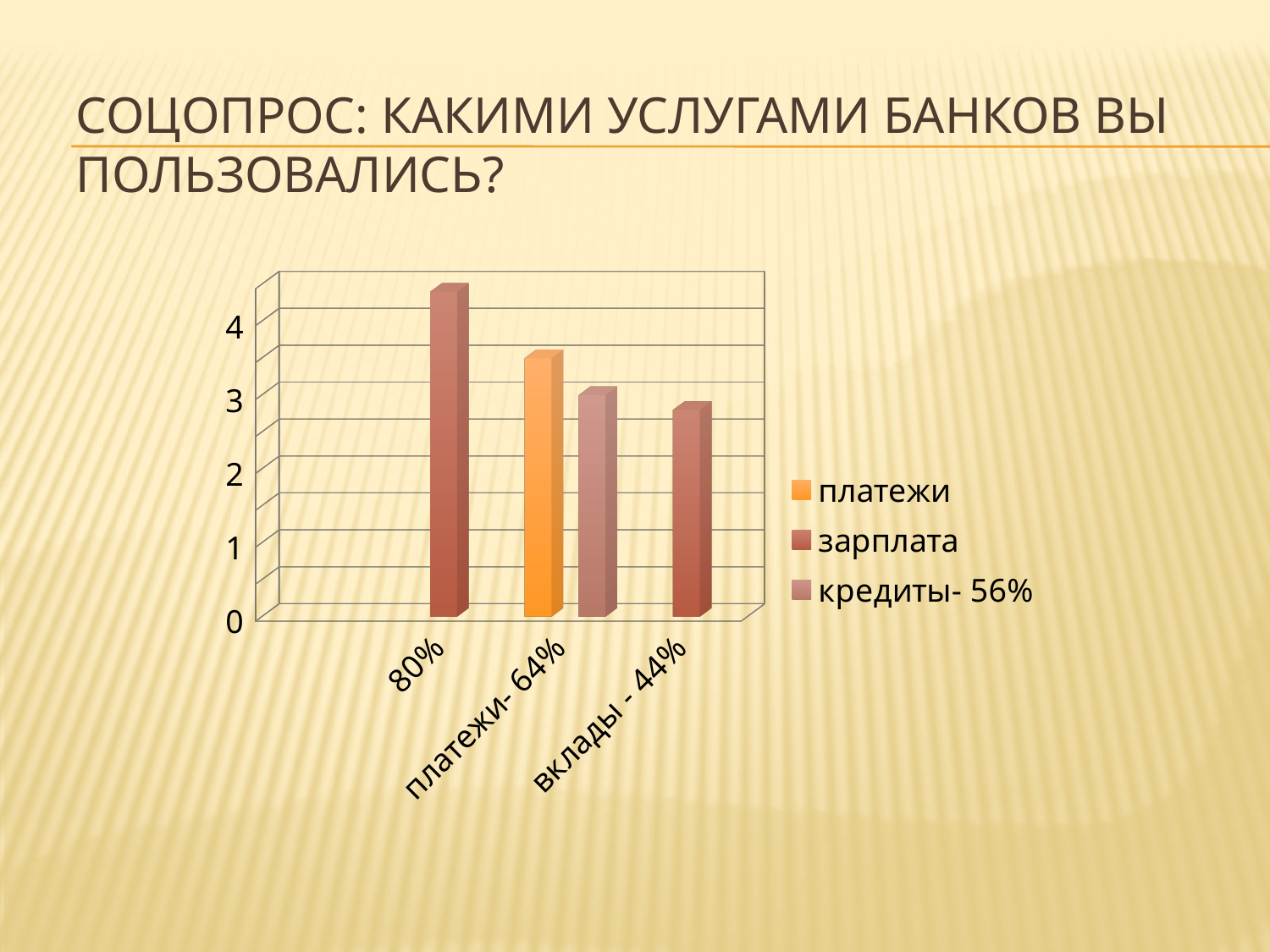
What kind of chart is shown on the slide? bar chart Which bar is the tallest in the chart? the leftmost bar Which bar is the shortest in the chart? the rightmost bar How many bars are plotted in the chart? 4 Is the value of the orange bar greater or less than 3? greater Do the bar heights rise or fall from left to right across the chart? fall Which is larger, the leftmost bar or the orange bar? the leftmost bar Is the value of the leftmost bar greater or less than 4? greater What is the third legend entry in the chart? кредиты- 56% How many series does the legend list? 3 Is the value of the rightmost bar greater or less than 3? less What is the legend entry shown in orange? платежи